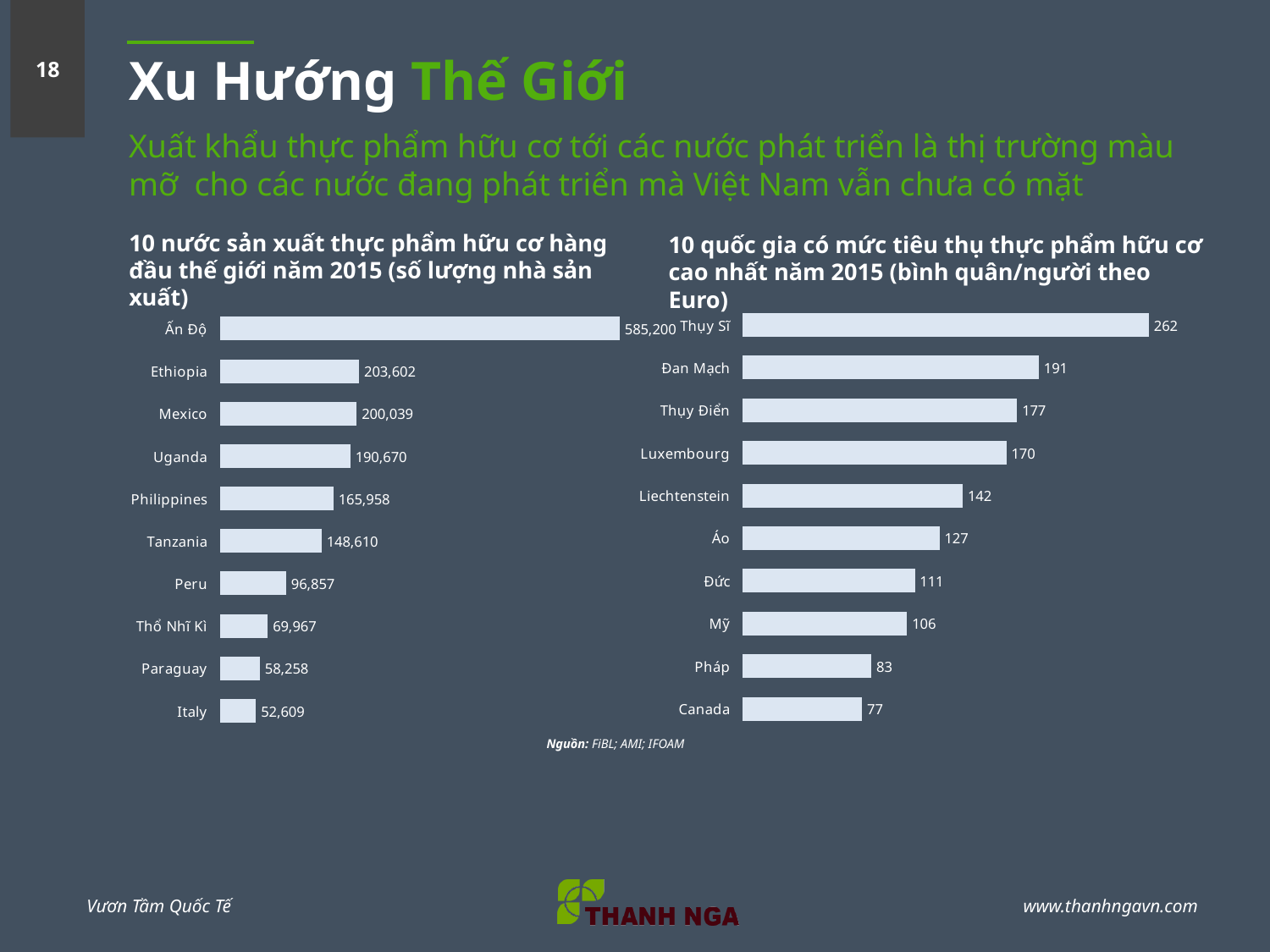
What kind of chart is the left chart (10 nước sản xuất thực phẩm hữu cơ hàng đầu thế giới năm 2015)? Bar chart In the left chart (10 nước sản xuất thực phẩm hữu cơ hàng đầu thế giới năm 2015), which country has the lowest value? Italy In the right chart (10 quốc gia có mức tiêu thụ thực phẩm hữu cơ cao nhất năm 2015), what is the difference between Thụy Sĩ and Đan Mạch? 71 In the right chart (10 quốc gia có mức tiêu thụ thực phẩm hữu cơ cao nhất năm 2015), what is the value for Liechtenstein? 142 What source is cited below the charts? FiBL; AMI; IFOAM In the right chart (10 quốc gia có mức tiêu thụ thực phẩm hữu cơ cao nhất năm 2015), which country has the highest value? Thụy Sĩ In the left chart (10 nước sản xuất thực phẩm hữu cơ hàng đầu thế giới năm 2015), what is the value for Uganda? 190,670 In the right chart (10 quốc gia có mức tiêu thụ thực phẩm hữu cơ cao nhất năm 2015), which country has the lowest value? Canada In the right chart (10 quốc gia có mức tiêu thụ thực phẩm hữu cơ cao nhất năm 2015), which is larger, Đức or Mỹ? Đức In the left chart (10 nước sản xuất thực phẩm hữu cơ hàng đầu thế giới năm 2015), what is the difference between Ethiopia and Mexico? 3,563 In the left chart (10 nước sản xuất thực phẩm hữu cơ hàng đầu thế giới năm 2015), how many countries are shown? 10 In the left chart (10 nước sản xuất thực phẩm hữu cơ hàng đầu thế giới năm 2015), which country has the highest value? Ấn Độ